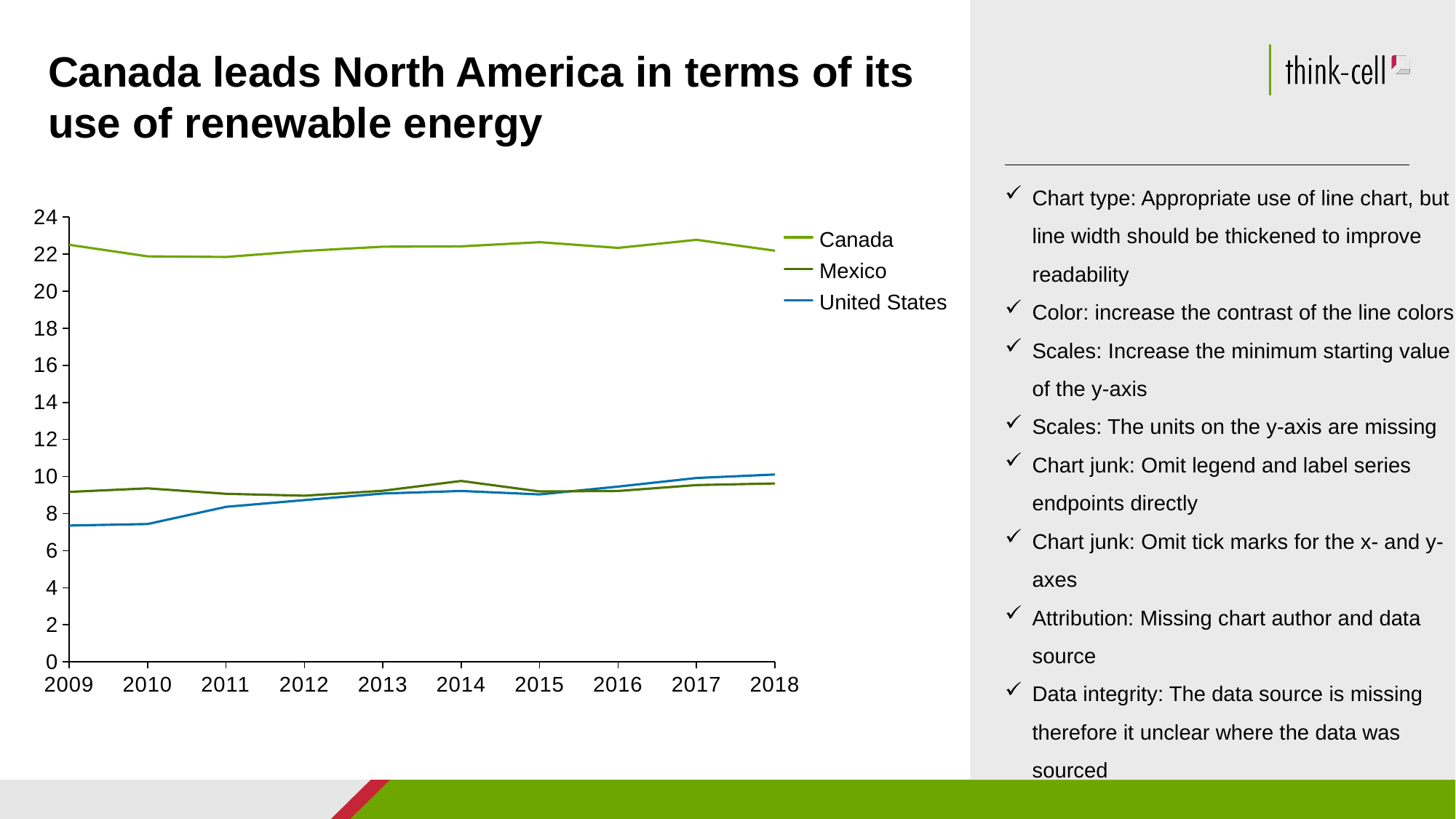
Is the value for Canada in 2017 greater or less than 22? greater What is the first year shown on the x axis? 2009 Which series has the lowest value in 2009? United States Is the value for Canada in 2018 greater or less than 20? greater Which series has the highest values across all years? Canada What kind of chart is shown on the slide? line chart How many series does the legend list? 3 Does the United States line rise or fall from 2009 to 2018? rise Is the value for Mexico in 2009 greater or less than 8? greater Which is larger in 2009, the value for Mexico or the value for United States? Mexico How many years are shown on the x axis? 10